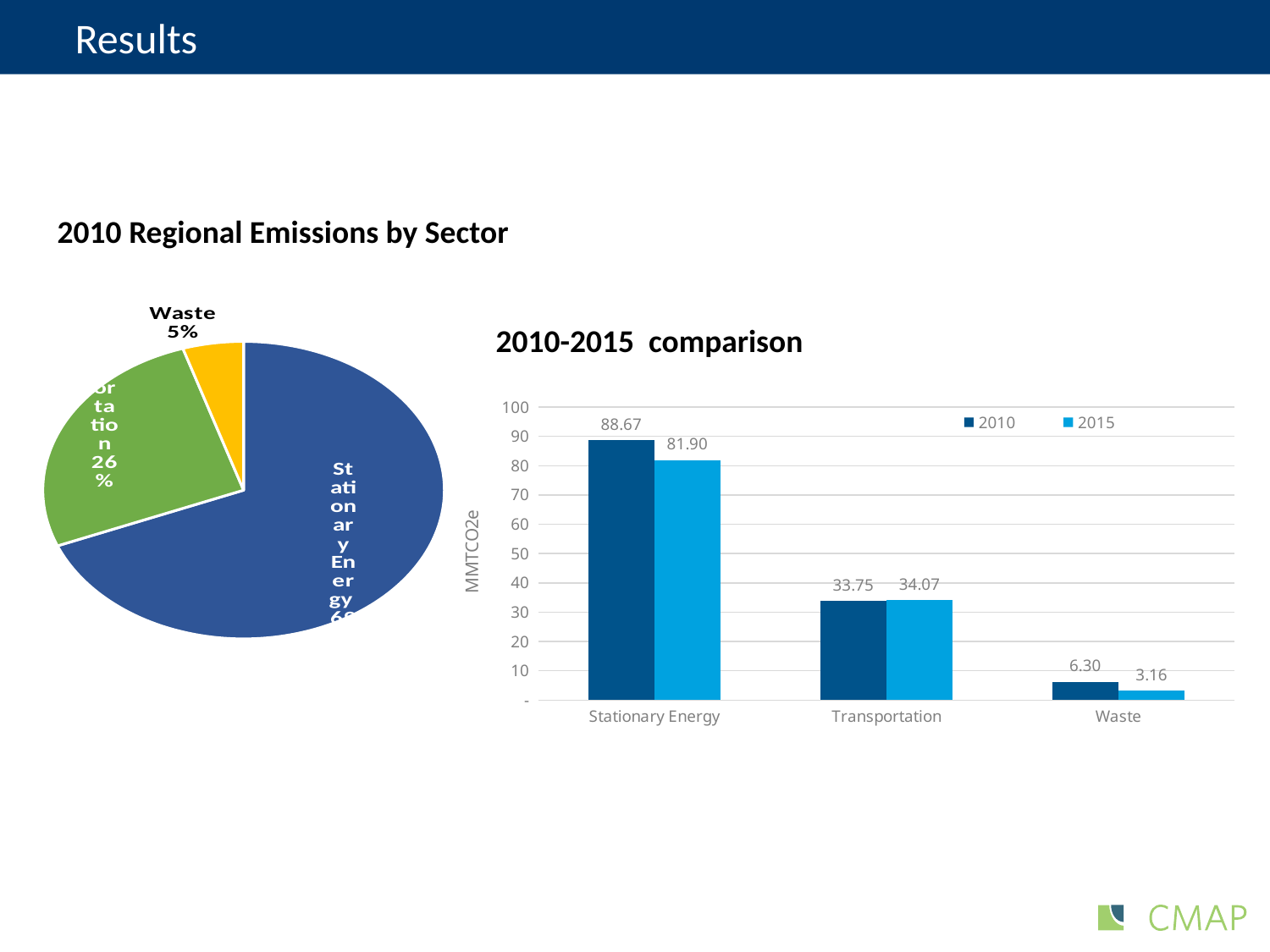
In the 2010-2015 comparison bar chart, how many categories are shown on the x axis? 3 In the 2010-2015 comparison bar chart, what is the difference between the 2010 and 2015 values for Waste? 3.14 In the 2010-2015 comparison bar chart, is the 2010 value for Waste larger or smaller than the 2015 value for Waste? larger In the 2010-2015 comparison bar chart, what is the 2015 value for Waste? 3.16 In the 2010-2015 comparison bar chart, what is the 2015 value for Transportation? 34.07 What type of chart is the 2010 Regional Emissions by Sector chart on the left? pie chart In the 2010 Regional Emissions by Sector pie chart, what share does Waste have? 5% In the 2010-2015 comparison bar chart, how many series does the legend list? 2 In the 2010-2015 comparison bar chart, which category has the lowest 2015 value? Waste In the 2010-2015 comparison bar chart, which category has the highest 2010 value? Stationary Energy In the 2010-2015 comparison bar chart, what is the difference between the 2010 and 2015 values for Stationary Energy? 6.77 In the 2010-2015 comparison bar chart, what is the 2010 value for Stationary Energy? 88.67